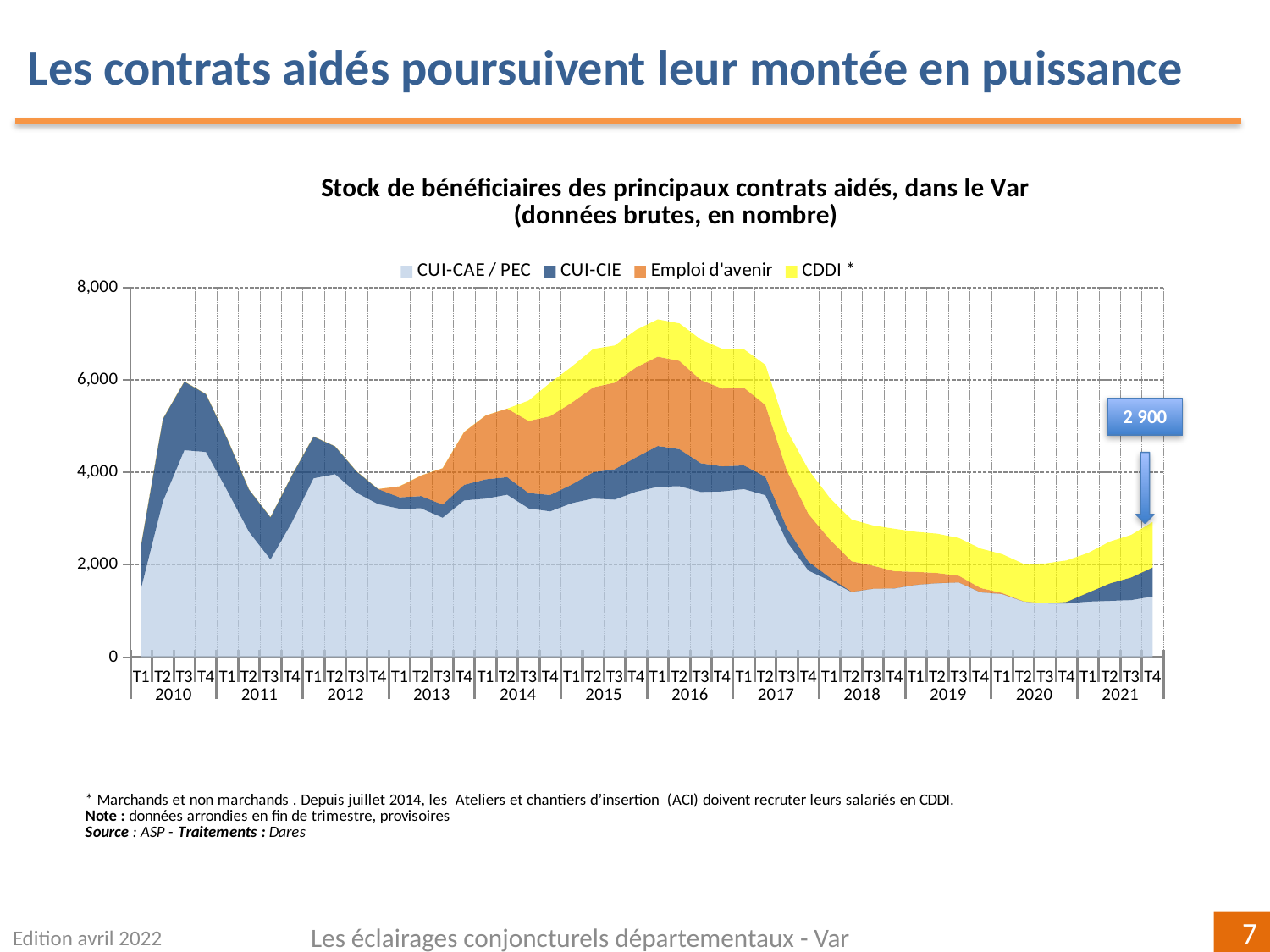
In which year does the total stock of beneficiaries reach its lowest level? 2020 How many series does the chart legend list? 4 What kind of chart is shown on the slide? Stacked area chart What value does the annotation at the right end of the chart show for T4 2021? 2 900 Does the total stock of beneficiaries rise or fall between T1 2016 and T1 2018? fall In which year does the total stock of beneficiaries reach its highest level? 2016 Is the total stock of beneficiaries at T1 2016 greater or less than 6,000? greater Does the total stock of beneficiaries rise or fall between T4 2020 and T4 2021? rise Which series is shown in yellow in the chart legend? CDDI * Is the total stock of beneficiaries at T4 2019 greater or less than 4,000? less How many years are shown along the x axis of the chart? 12 How many quarterly data points are plotted on the chart (T1 2010 to T4 2021)? 48